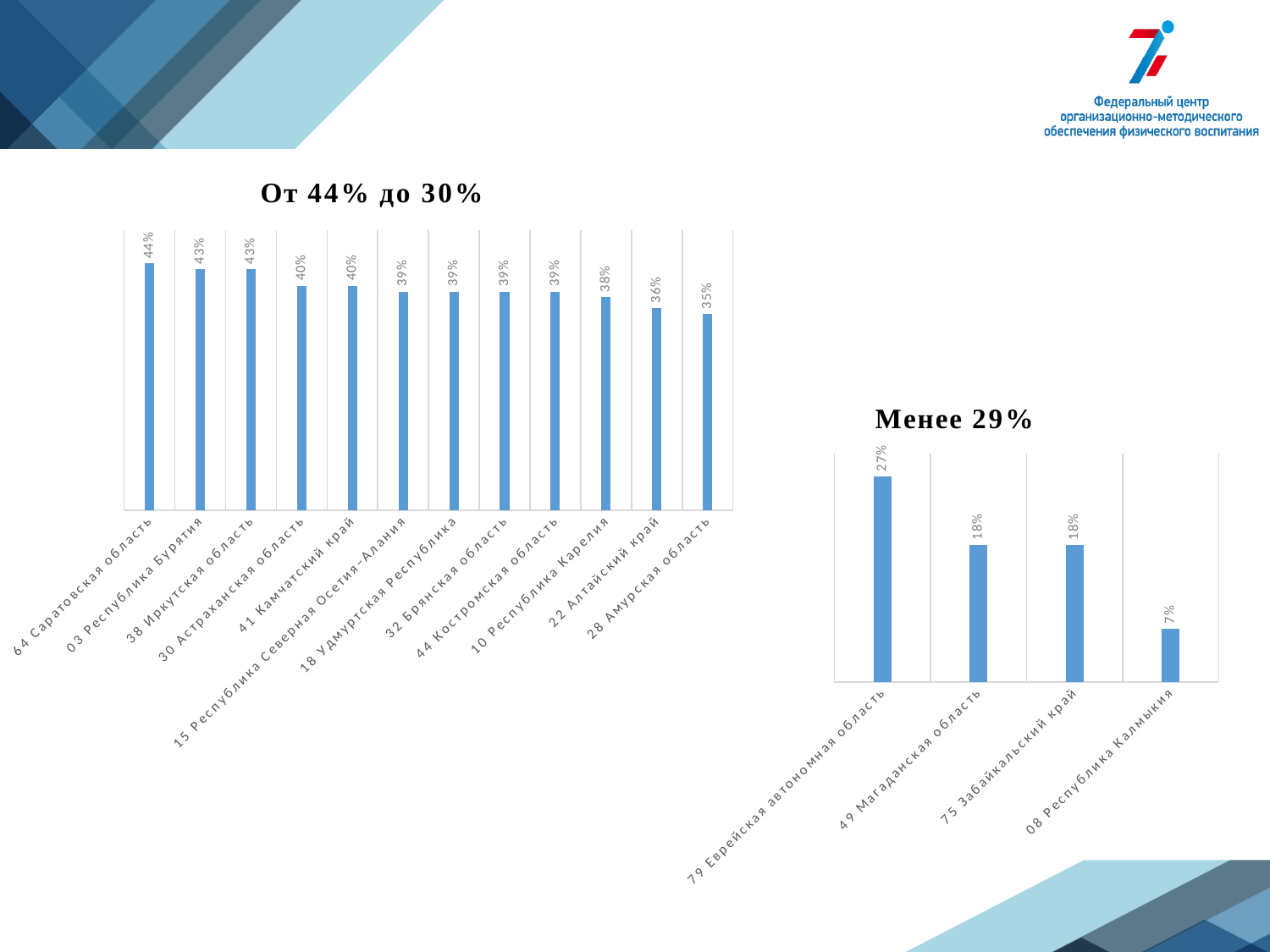
In the chart titled "От 44% до 30%", how many categories are plotted? 12 In the chart titled "Менее 29%", what is the difference between the values for 79 Еврейская автономная область and 49 Магаданская область? 9% In the chart titled "Менее 29%", which is larger: the value for 75 Забайкальский край or the value for 08 Республика Калмыкия? 75 Забайкальский край In the chart titled "От 44% до 30%", do the values rise or fall from left to right along the x axis? fall In the chart titled "Менее 29%", which category has the lowest value? 08 Республика Калмыкия In the chart titled "От 44% до 30%", which category has the lowest value? 28 Амурская область In the chart titled "От 44% до 30%", what is the value for 22 Алтайский край? 36% In the chart titled "Менее 29%", how many categories are plotted? 4 In the chart titled "От 44% до 30%", what is the value for 64 Саратовская область? 44% In the chart titled "Менее 29%", what is the value for 79 Еврейская автономная область? 27% What kind of chart is the chart titled "Менее 29%"? bar chart In the chart titled "От 44% до 30%", what is the difference between the values for 64 Саратовская область and 28 Амурская область? 9%